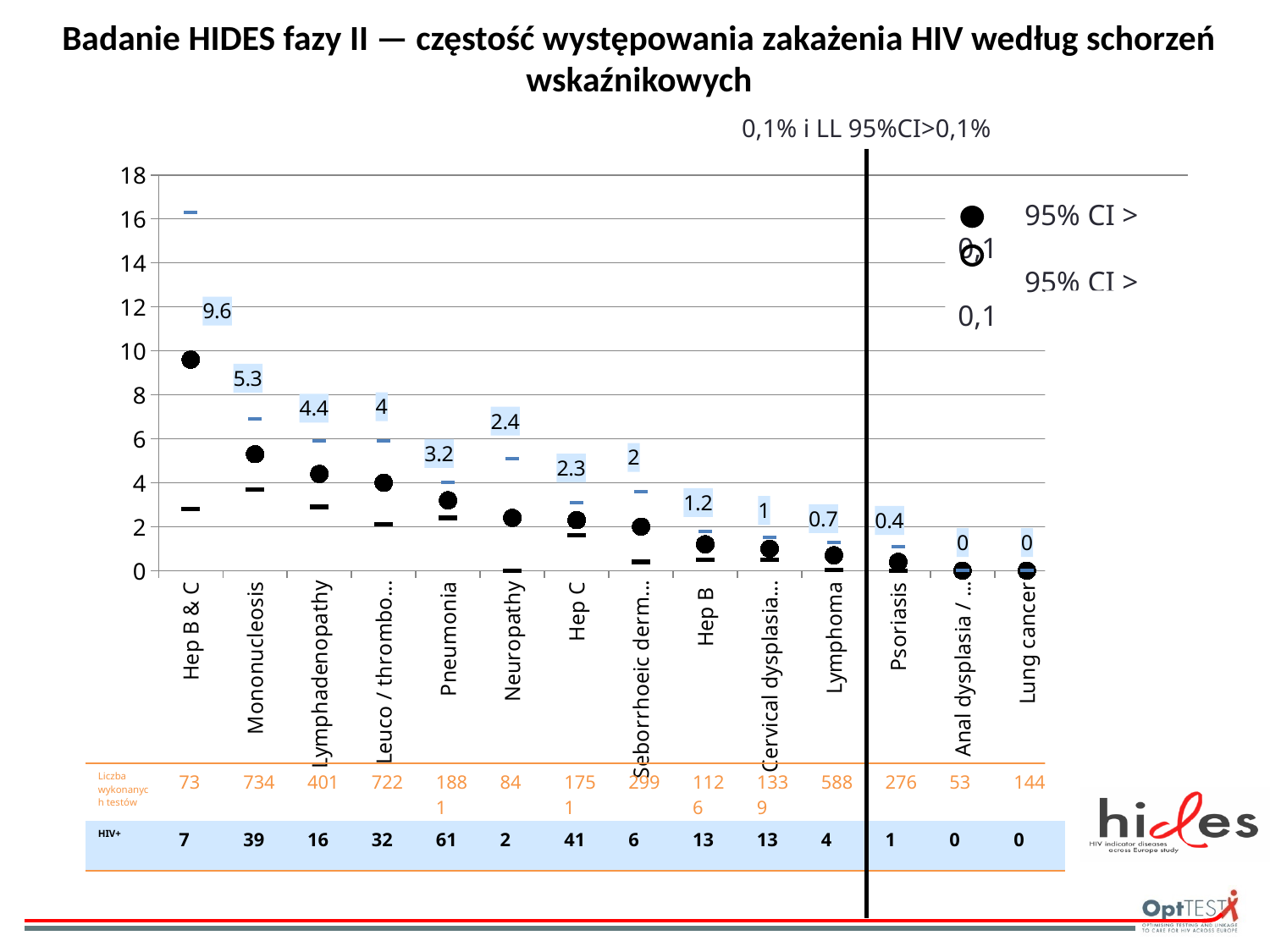
What is the difference between the plotted values for Lymphadenopathy and Hep C? 2.1 How many indicator conditions are shown on the x axis? 14 What kind of chart is shown on the slide? scatter chart What is the value plotted for Psoriasis? 0.4 What is the value plotted for Pneumonia? 3.2 Which has a larger plotted value, Neuropathy or Hep B? Neuropathy Which indicator condition has the highest plotted value? Hep B & C What is the difference between the plotted values for Hep B & C and Mononucleosis? 4.3 Do the plotted values rise or fall from left to right along the x axis? fall Is the plotted value for Hep B & C greater or less than 8? greater What is the HIV prevalence value plotted for Hep B & C? 9.6 What is the value plotted for Mononucleosis? 5.3